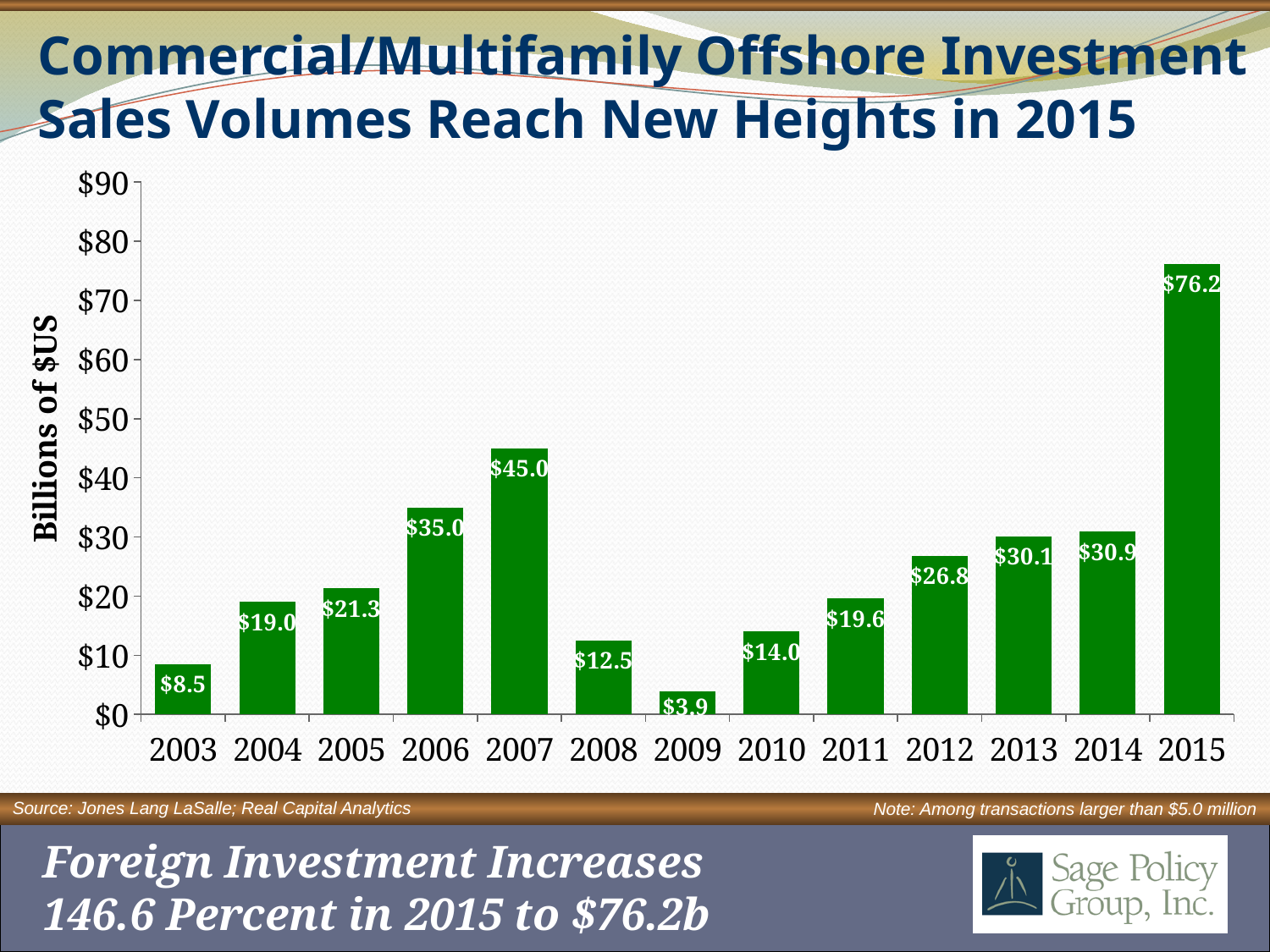
What is the value for 2007? $45.0 What is the value for 2009? $3.9 Which year has the lowest value? 2009 Is the value for 2012 greater or less than $20? greater What is the label of the y axis? Billions of $US What kind of chart is shown? bar chart What is the difference between the values for 2015 and 2014? $45.3 Which is larger, the value for 2006 or the value for 2007? 2007 How many years are shown on the x axis? 13 What is the value for 2015? $76.2 Which year has the highest value? 2015 Do the values rise or fall from 2009 to 2015? rise